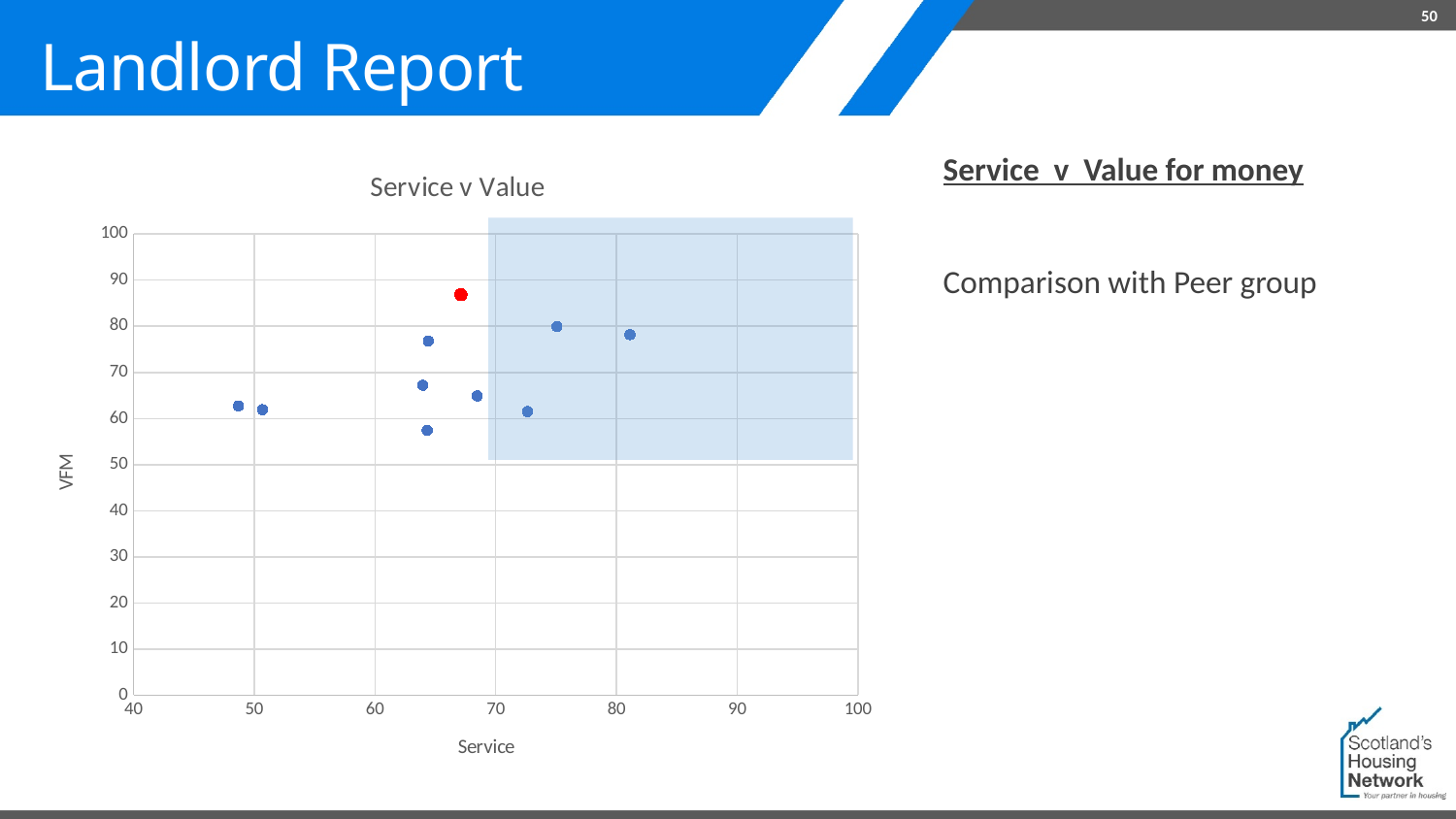
Which point has the highest VFM value? The red point What are the labels of the x axis and y axis of the chart? Service (x axis) and VFM (y axis) Is the highest Service value on the chart greater or less than 90? less What kind of chart is shown on the slide? Scatter chart Are there any points with a VFM value below 50? No Is the Service value of the red point greater or less than 70? less How many data points are plotted on the chart? 10 How many points have a Service value greater than 70? 3 What is the title of the chart? Service v Value